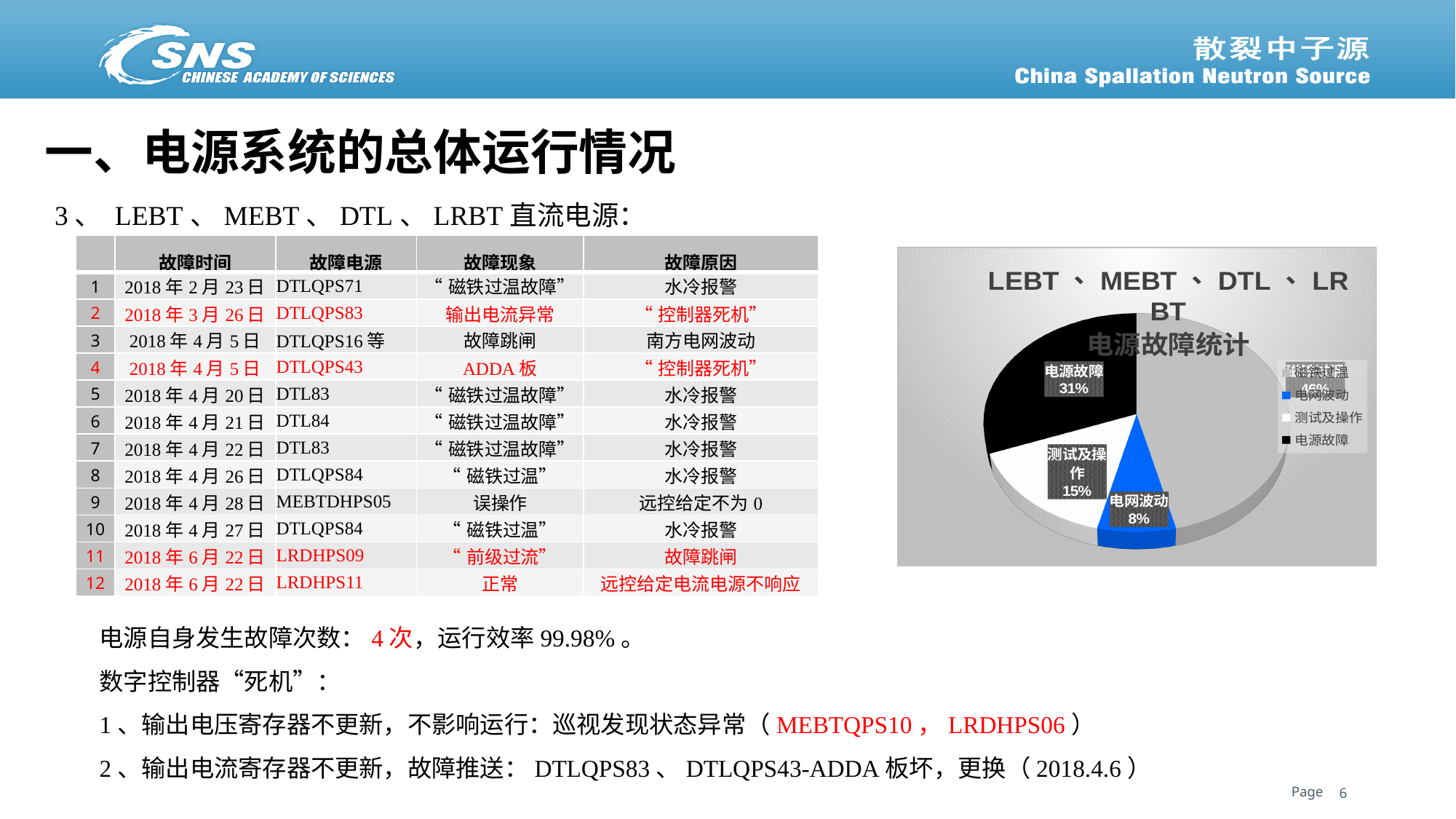
What percentage is shown for 磁铁过温? 46% Which is larger, the share for 电源故障 or the share for 测试及操作? 电源故障 What share of the pie does 电源故障 account for? 31% What percentage is shown for 电网波动? 8% What percentage is shown for 测试及操作? 15% How many categories does the pie chart have? 4 Which category has the smallest slice of the pie? 电网波动 What colour is the 电网波动 slice? blue What kind of chart is shown on the slide? pie chart How many percentage points larger is 电源故障 than 电网波动? 23% What is the title of the pie chart? LEBT、MEBT、DTL、LRBT 电源故障统计 Which category has the largest slice of the pie? 磁铁过温